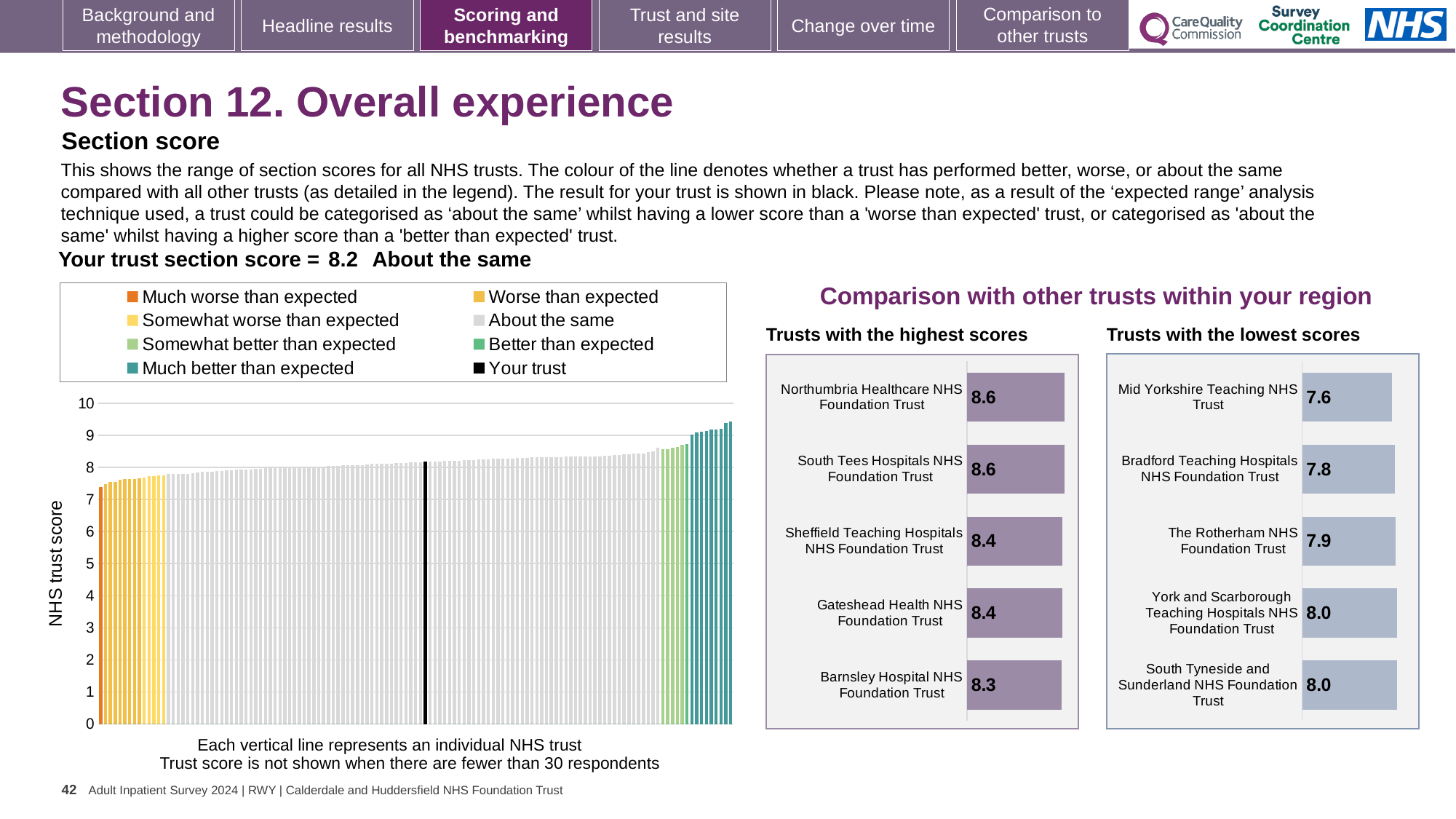
In the 'Trusts with the highest scores' chart, what is the score for Barnsley Hospital NHS Foundation Trust? 8.3 In the main NHS trust score chart on the left, how many entries does the legend list? 8 In the main NHS trust score chart on the left, do the values rise or fall from left to right along the x axis? rise How many trusts are listed in the 'Trusts with the lowest scores' chart? 5 In the 'Trusts with the highest scores' chart, which trust has the lowest score? Barnsley Hospital NHS Foundation Trust In the 'Trusts with the lowest scores' chart, what is the difference between the scores of Bradford Teaching Hospitals NHS Foundation Trust and Mid Yorkshire Teaching NHS Trust? 0.2 In the 'Trusts with the highest scores' chart, what is the score for Northumbria Healthcare NHS Foundation Trust? 8.6 In the 'Trusts with the lowest scores' chart, which trust has the lowest score? Mid Yorkshire Teaching NHS Trust In the 'Trusts with the highest scores' chart, what is the difference between the scores of Northumbria Healthcare NHS Foundation Trust and Barnsley Hospital NHS Foundation Trust? 0.3 In the 'Trusts with the lowest scores' chart, which has the larger score: Bradford Teaching Hospitals NHS Foundation Trust or The Rotherham NHS Foundation Trust? The Rotherham NHS Foundation Trust In the main NHS trust score chart on the left, is the value of the leftmost bar greater or less than 8? less In the 'Trusts with the lowest scores' chart, what is the score for Mid Yorkshire Teaching NHS Trust? 7.6